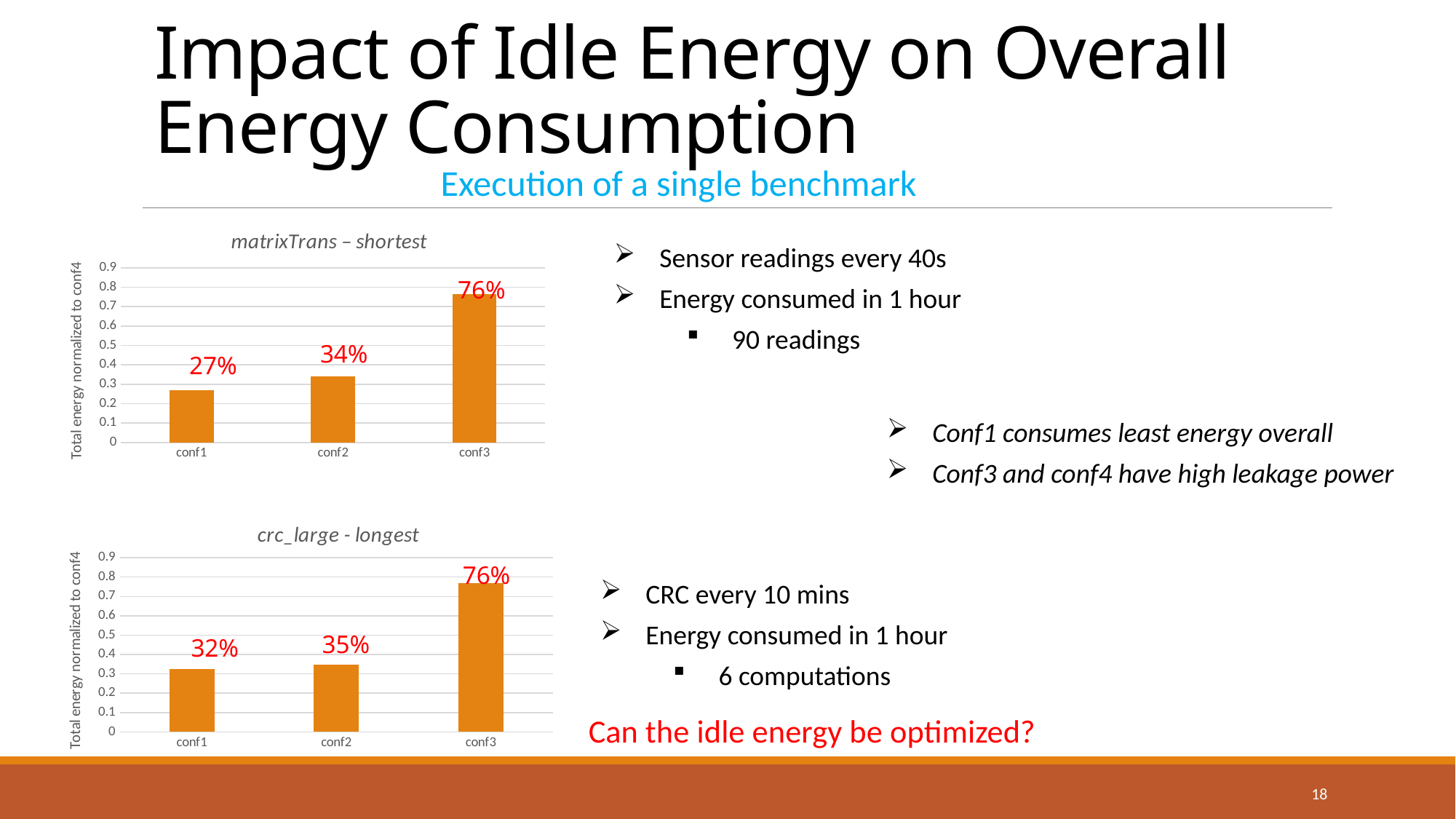
In the 'crc_large - longest' chart, what is the data label for conf1? 32% In the 'crc_large - longest' chart, what is the data label for conf2? 35% In the 'matrixTrans – shortest' chart, is the bar for conf2 greater or less than 0.5 on the y axis? less What is the y-axis label of the 'crc_large - longest' chart? Total energy normalized to conf4 What type of chart is the 'matrixTrans – shortest' chart? bar chart In the 'matrixTrans – shortest' chart, what is the data label for conf3? 76% In the 'matrixTrans – shortest' chart, which configuration has the highest bar? conf3 In the 'crc_large - longest' chart, which is larger, the value for conf2 or conf3? conf3 In the 'matrixTrans – shortest' chart, what is the data label for conf1? 27% In the 'matrixTrans – shortest' chart, what is the difference in percentage points between the labels for conf3 and conf1? 49 In the 'crc_large - longest' chart, which configuration has the lowest bar? conf1 How many configurations are shown on the x axis of the 'crc_large - longest' chart? 3